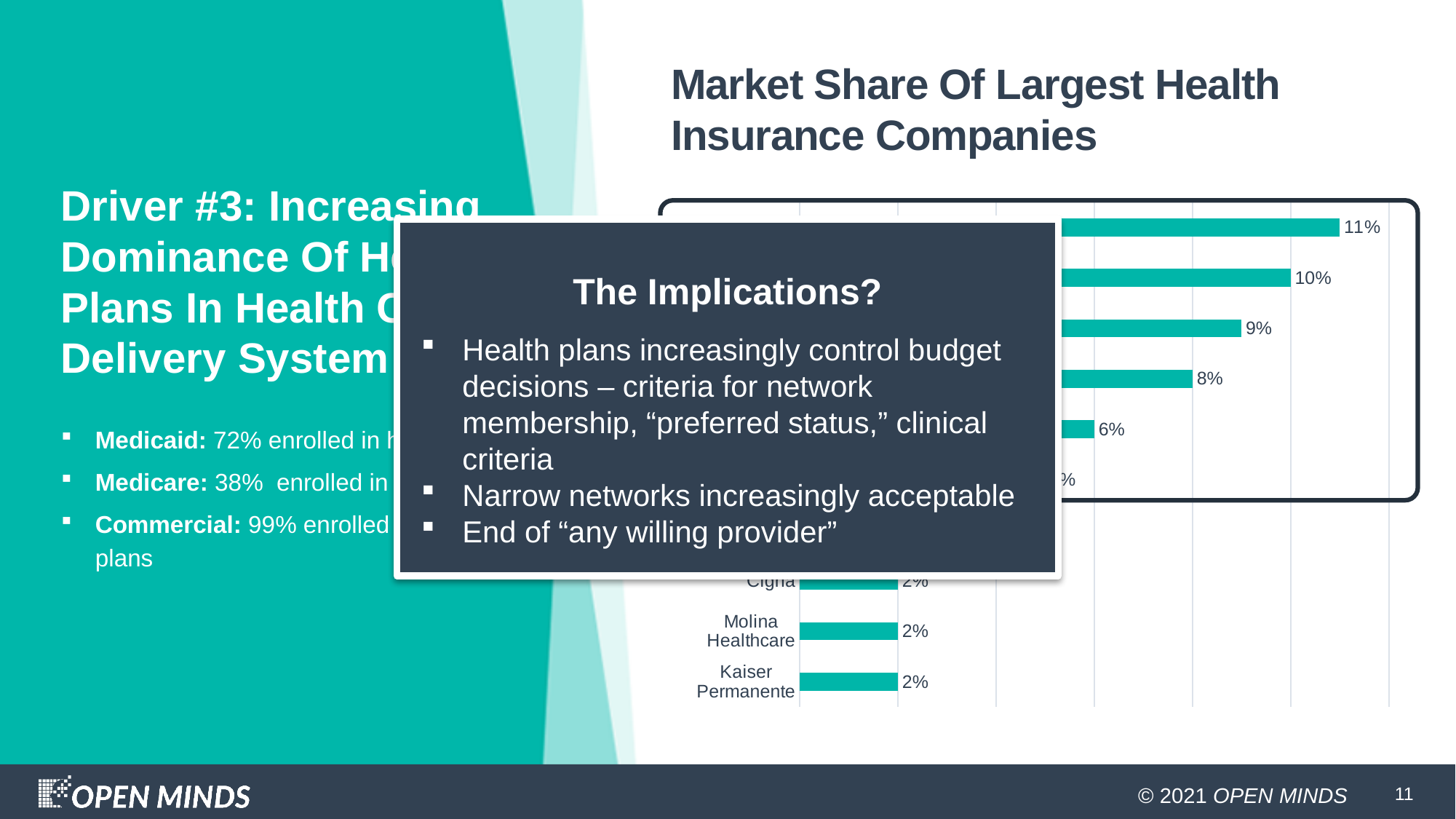
Is the value for Kaiser Permanente larger or smaller than the largest labeled value of 11%? smaller What is the market share value shown for Molina Healthcare? 2% What kind of chart is shown on the slide? bar chart What is the difference between the largest labeled value (11%) and the second-largest labeled value (10%) on the chart? 1% What is the largest value labeled on the chart? 11% What is the title of the chart on the slide? Market Share Of Largest Health Insurance Companies Are the bars in the chart drawn horizontally or vertically? horizontally What is the market share value shown for Kaiser Permanente? 2%